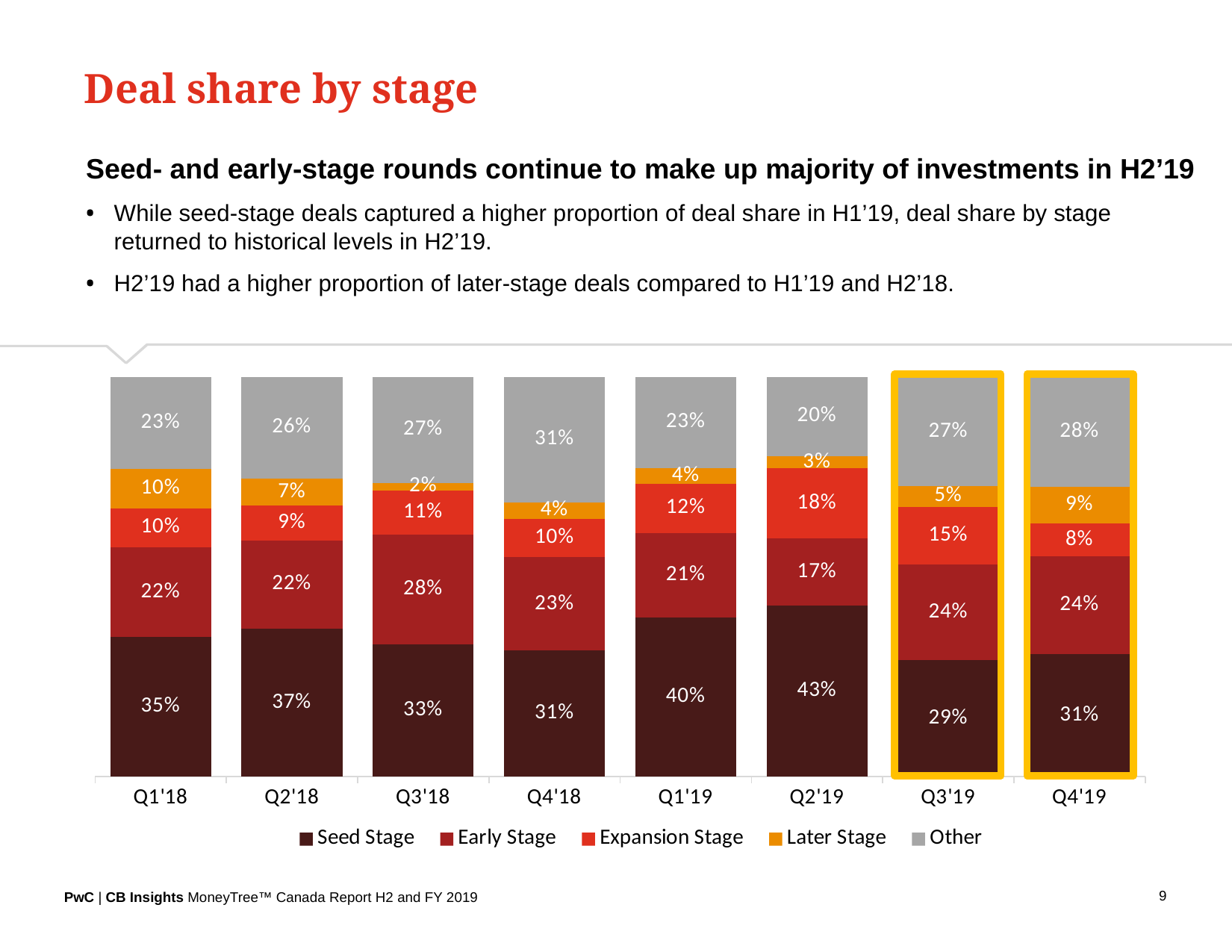
Which quarter has the larger Expansion Stage share, Q1'19 or Q2'19? Q2'19 What is the Other share in Q4'18? 31% What is the Later Stage share in Q4'19? 9% What is the Seed Stage share in Q2'19? 43% In which quarter is the Later Stage share lowest? Q3'18 What kind of chart is shown on the slide? Stacked bar chart In which quarter is the Seed Stage share highest? Q2'19 In which quarter is the Seed Stage share lowest? Q3'19 Which quarters are highlighted with a yellow outline? Q3'19 and Q4'19 How many series does the legend list? 5 What is the difference between the Seed Stage share in Q2'19 and in Q3'19? 14 percentage points How many quarters are shown on the x axis? 8